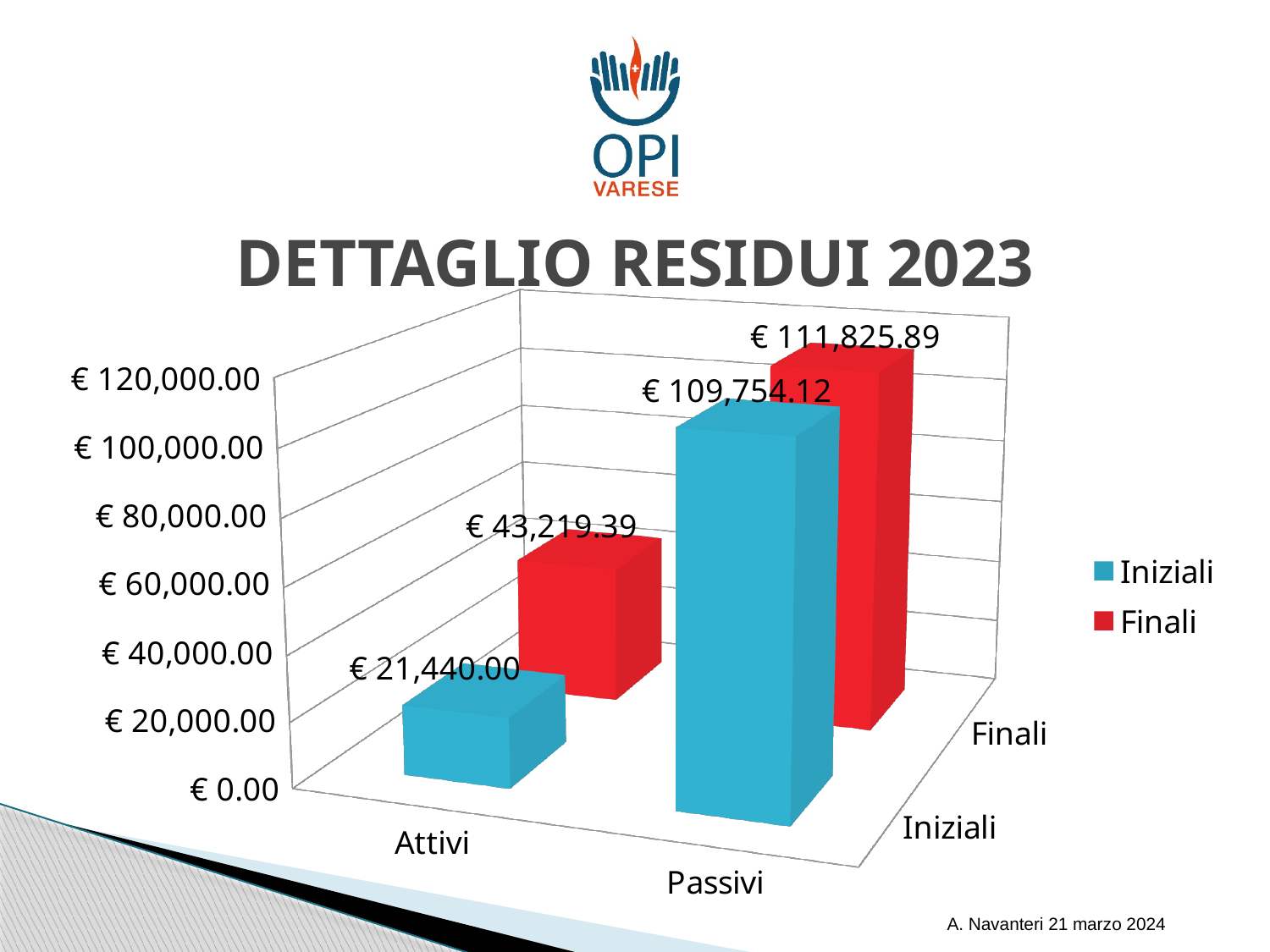
What is the difference between Finali and Iniziali for Attivi? € 21,779.39 What is the title of the chart? DETTAGLIO RESIDUI 2023 What is the value of Finali for Passivi? € 111,825.89 How many series does the legend list? 2 Which bar has the lowest value in the chart? Attivi Iniziali What is the value of Iniziali for Passivi? € 109,754.12 What is the value of Iniziali for Attivi? € 21,440.00 Which is larger for Passivi, Iniziali or Finali? Finali What is the value of Finali for Attivi? € 43,219.39 Which bar has the highest value in the chart? Passivi Finali How many categories are shown on the x axis? 2 What is the difference between Finali and Iniziali for Passivi? € 2,071.77